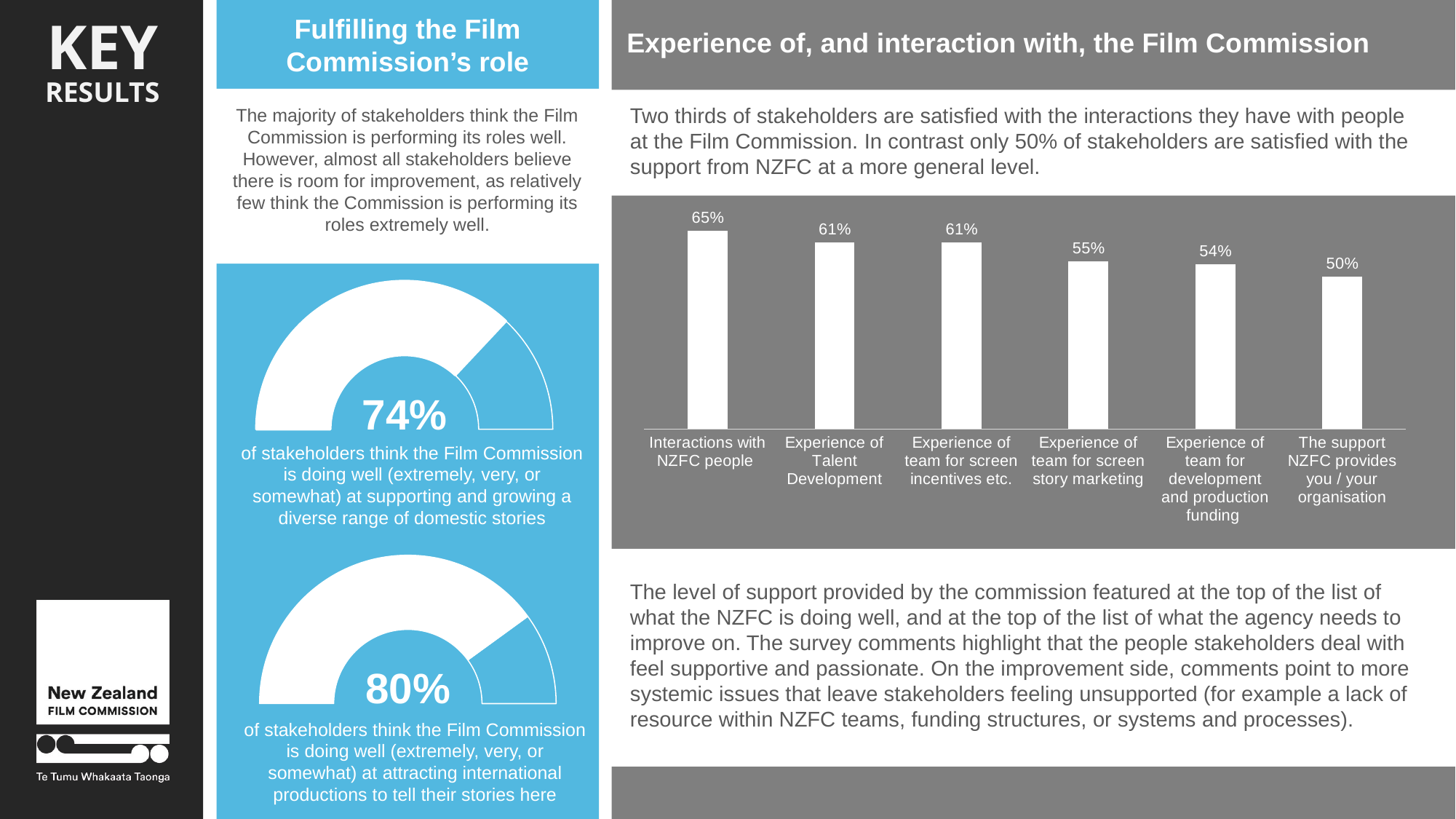
In the bar chart under 'Experience of, and interaction with, the Film Commission', which is larger: 'Experience of Talent Development' or 'Experience of team for development and production funding'? Experience of Talent Development In the bar chart under 'Experience of, and interaction with, the Film Commission', what is the value for 'The support NZFC provides you / your organisation'? 50% In the bar chart under 'Experience of, and interaction with, the Film Commission', what is the difference between 'Interactions with NZFC people' and 'The support NZFC provides you / your organisation'? 15% In the bar chart under 'Experience of, and interaction with, the Film Commission', what is the value for 'Experience of team for screen story marketing'? 55% In the bar chart under 'Experience of, and interaction with, the Film Commission', do the values rise or fall from left to right? Fall In the bar chart under 'Experience of, and interaction with, the Film Commission', what is the value for 'Interactions with NZFC people'? 65% In the bar chart under 'Experience of, and interaction with, the Film Commission', which category has the highest value? Interactions with NZFC people What kind of chart is shown under 'Experience of, and interaction with, the Film Commission'? Bar chart In the lower gauge chart on the left, what percentage of stakeholders think the Film Commission is doing well at attracting international productions? 80% In the upper gauge chart on the left, what percentage of stakeholders think the Film Commission is doing well at supporting and growing a diverse range of domestic stories? 74% In the bar chart under 'Experience of, and interaction with, the Film Commission', which category has the lowest value? The support NZFC provides you / your organisation In the bar chart under 'Experience of, and interaction with, the Film Commission', how many categories are shown? 6